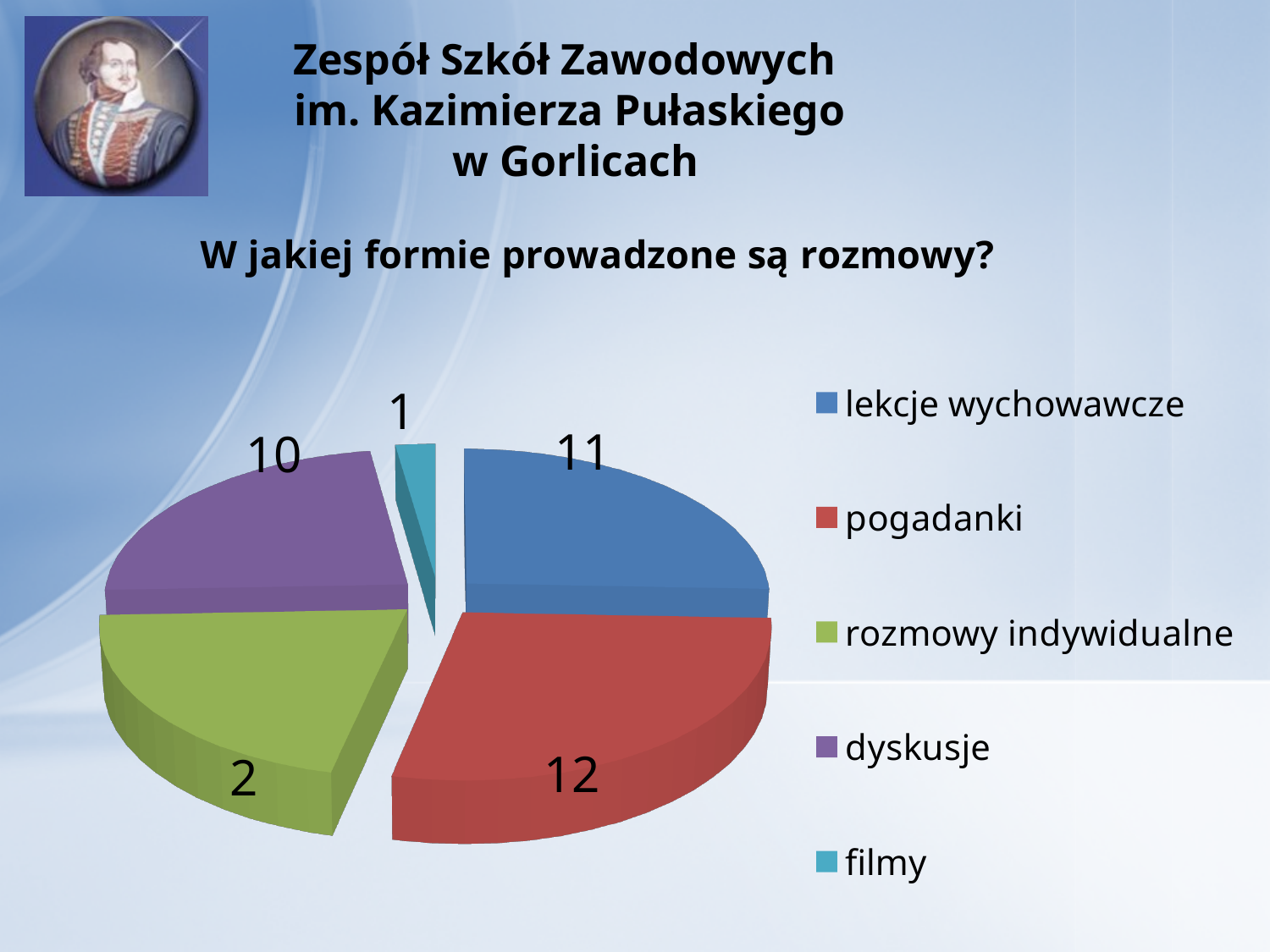
What is the value for pogadanki? 12 Which category has the highest value? pogadanki What colour is the slice for pogadanki? red What is the value for lekcje wychowawcze? 11 What kind of chart is shown on the slide? pie chart What is the difference between the values for pogadanki and lekcje wychowawcze? 1 What is the value for dyskusje? 10 What is the title of the chart? W jakiej formie prowadzone są rozmowy? Which category has the lowest value? filmy What is the value for filmy? 1 How many categories does the legend list? 5 Which is larger, the value for lekcje wychowawcze or the value for dyskusje? lekcje wychowawcze